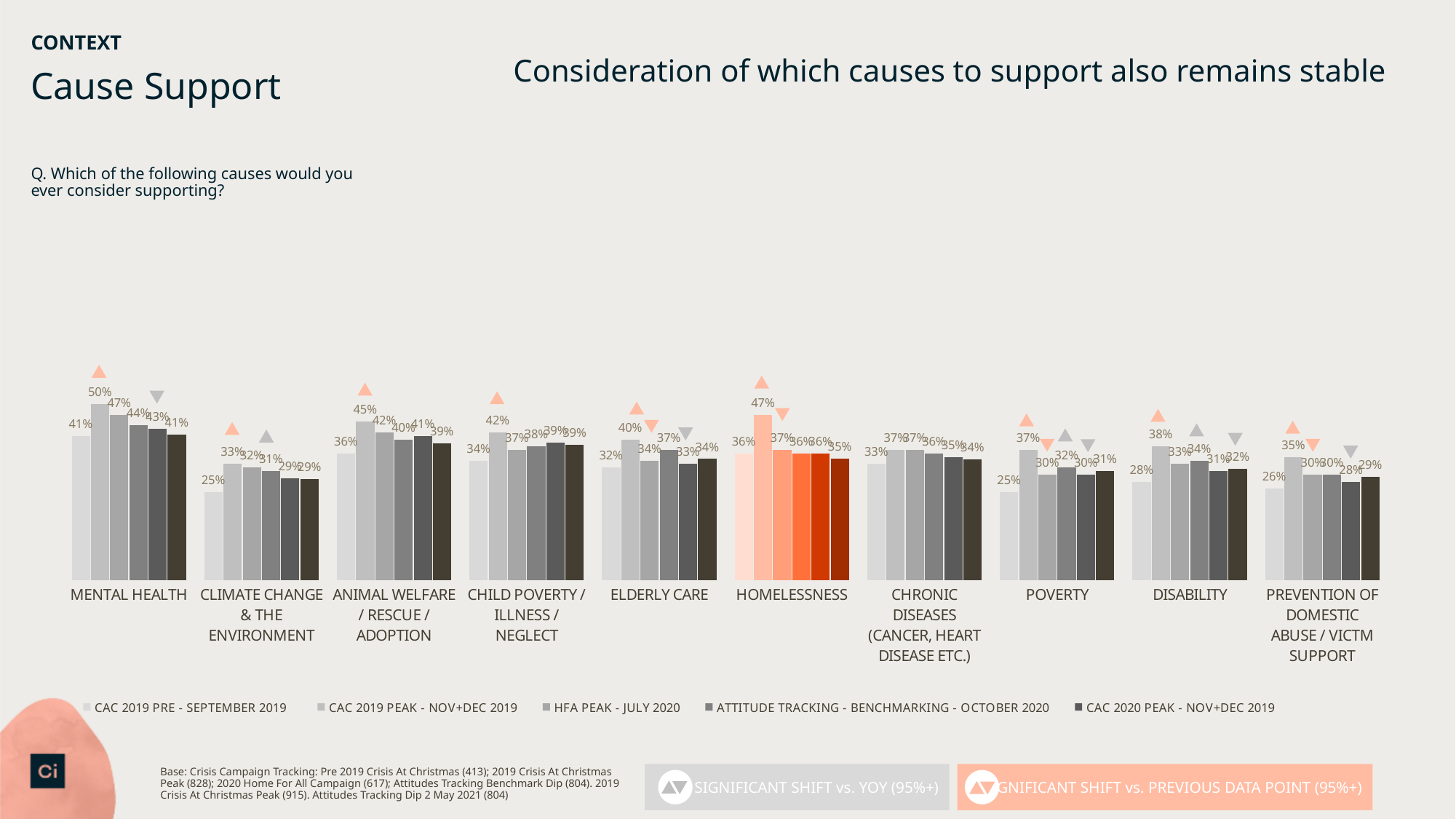
What is the CAC 2019 PRE - SEPTEMBER 2019 value for MENTAL HEALTH? 41% How many causes are shown on the x axis of the chart? 10 Which cause has the highest CAC 2019 PEAK - NOV+DEC 2019 value? MENTAL HEALTH Which cause has the lowest CAC 2019 PEAK - NOV+DEC 2019 value? CLIMATE CHANGE & THE ENVIRONMENT What is the CAC 2019 PEAK - NOV+DEC 2019 value for HOMELESSNESS? 47% How many series does the legend list? 5 What is the HFA PEAK - JULY 2020 value for ANIMAL WELFARE / RESCUE / ADOPTION? 42% Which has the larger CAC 2019 PEAK - NOV+DEC 2019 value: ANIMAL WELFARE / RESCUE / ADOPTION or CHILD POVERTY / ILLNESS / NEGLECT? ANIMAL WELFARE / RESCUE / ADOPTION For MENTAL HEALTH, how much higher is the CAC 2019 PEAK - NOV+DEC 2019 value than the CAC 2019 PRE - SEPTEMBER 2019 value? 9 percentage points For HOMELESSNESS, what is the difference between the CAC 2019 PEAK - NOV+DEC 2019 value and the CAC 2019 PRE - SEPTEMBER 2019 value? 11 percentage points What is the CAC 2019 PRE - SEPTEMBER 2019 value for DISABILITY? 28% What kind of chart is shown on the slide? Bar chart